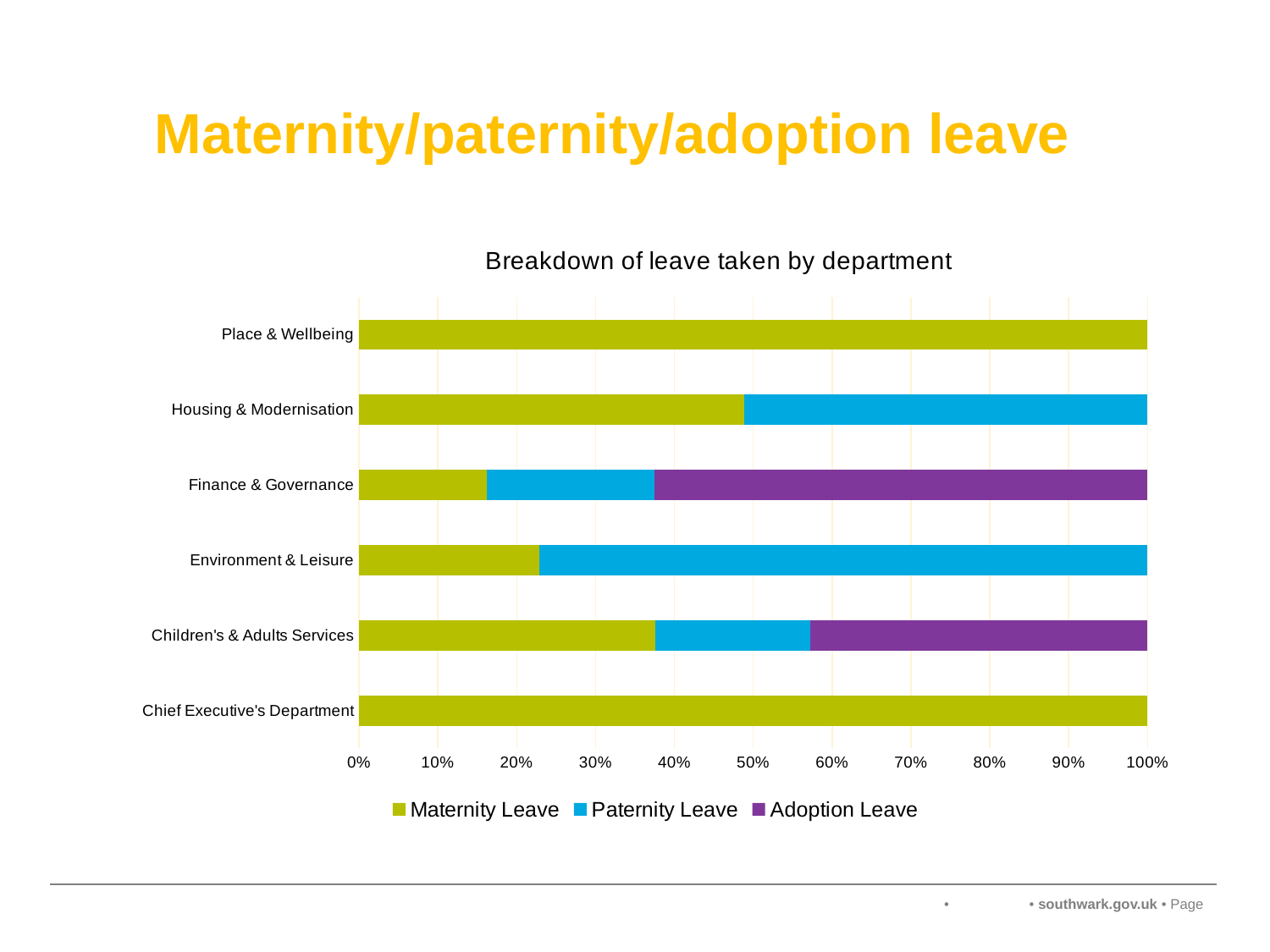
How many series does the legend list? 3 What is the title of the chart? Breakdown of leave taken by department What share of leave taken in Place & Wellbeing is Maternity Leave? 100% Which department has the smallest Maternity Leave share? Finance & Governance Is the Maternity Leave share for Environment & Leisure greater or less than 20%? greater What kind of chart is shown on the slide? Stacked bar chart Which department has the largest Adoption Leave share? Finance & Governance Which series is shown in purple in the legend? Adoption Leave Which has the larger Adoption Leave share, Finance & Governance or Children's & Adults Services? Finance & Governance How many departments are shown on the chart? 6 Is the Maternity Leave share for Finance & Governance greater or less than 20%? less Is the Maternity Leave share for Children's & Adults Services greater or less than 40%? less